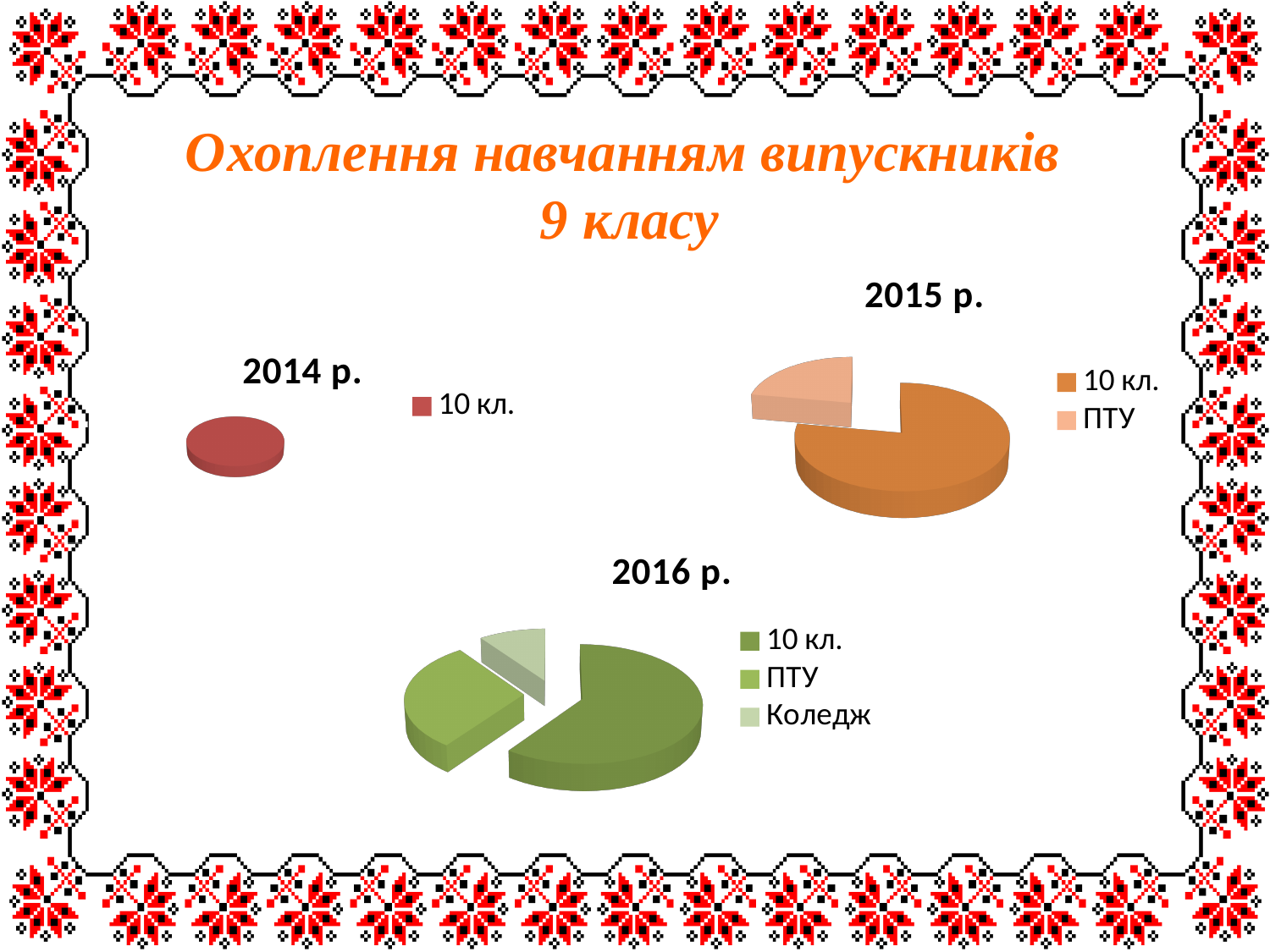
What is the title of the slide containing the three pie charts? Охоплення навчанням випускників 9 класу What kind of chart is the "2014 р." chart? pie chart In the "2016 р." chart, which category has the largest slice? 10 кл. In the "2015 р." chart, which category has the largest slice? 10 кл. In the "2016 р." chart, which category has the smallest slice? Коледж In the "2016 р." chart, which slice is larger: ПТУ or Коледж? ПТУ How many categories does the legend of the "2016 р." chart list? 3 How many categories does the legend of the "2014 р." chart list? 1 What kind of chart is the "2016 р." chart? pie chart What is the only category shown in the "2014 р." chart? 10 кл. How many categories does the legend of the "2015 р." chart list? 2 In the "2015 р." chart, which slice is larger: 10 кл. or ПТУ? 10 кл.